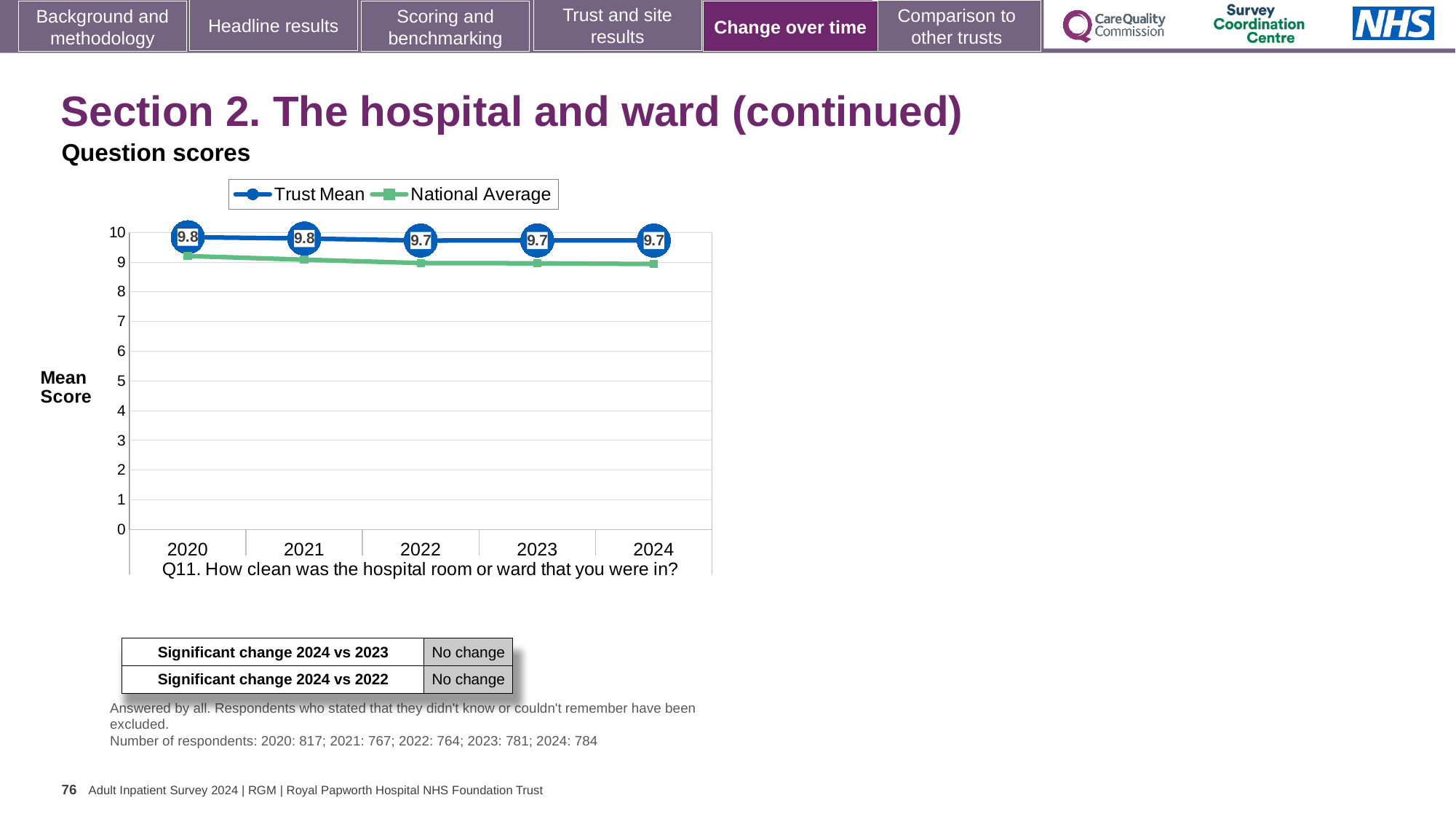
What is the Trust Mean score for 2022? 9.7 Is the National Average value for 2020 greater or less than 9? greater Does the Trust Mean rise or fall from 2020 to 2024? fall How many series does the legend list? 2 What is the label on the y axis? Mean Score Which series has the higher value in 2023, Trust Mean or National Average? Trust Mean What is the Trust Mean score for 2020? 9.8 How many years are shown on the x axis? 5 What kind of chart is shown? line chart What is the difference between the Trust Mean score in 2020 and in 2024? 0.1 What is the Trust Mean score for 2024? 9.7